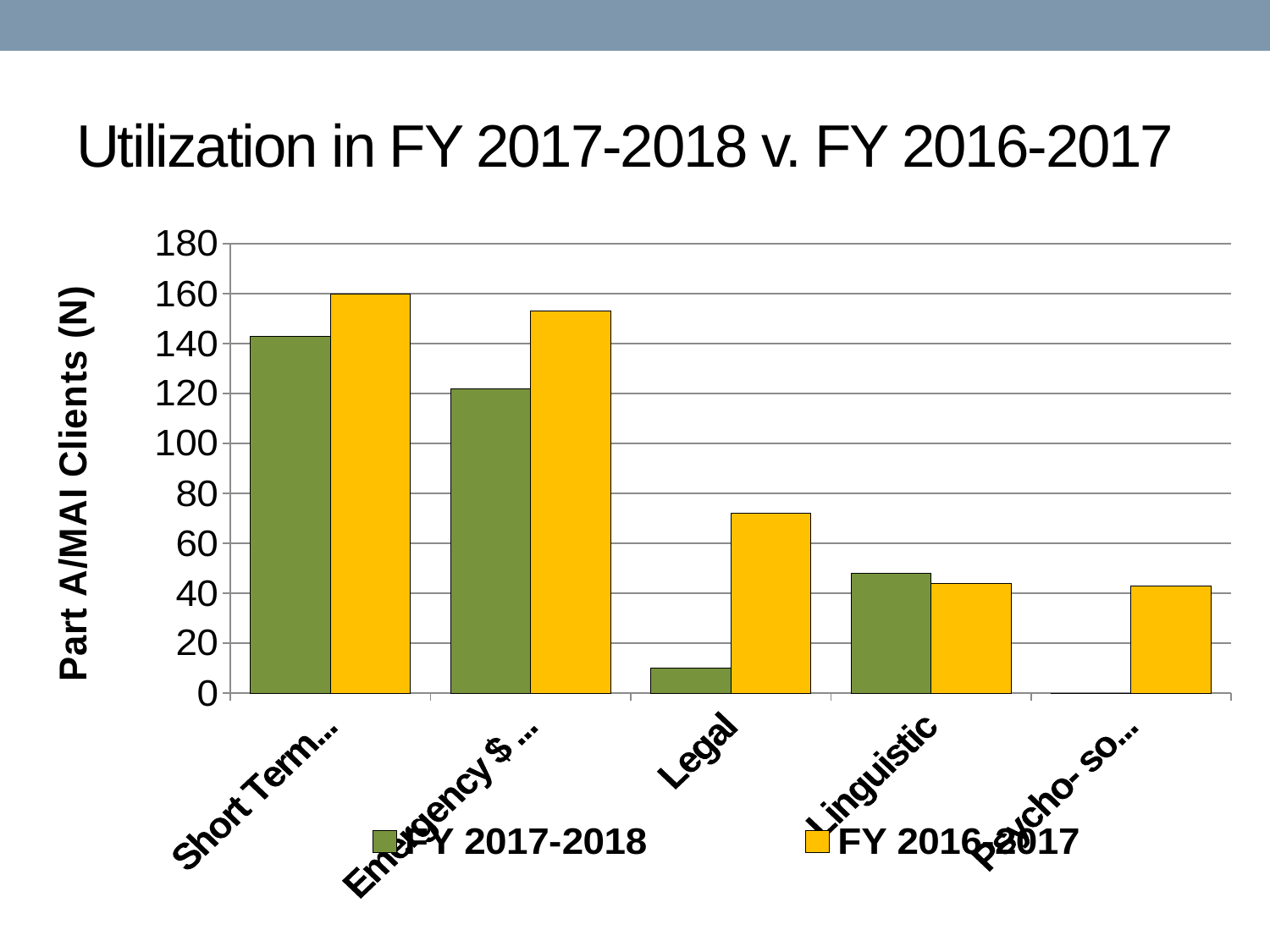
Is the FY 2017-2018 value for Legal greater or less than 20? less For Legal, which series has the larger value, FY 2017-2018 or FY 2016-2017? FY 2016-2017 What is the label of the vertical axis? Part A/MAI Clients (N) What kind of chart is shown on the slide? bar chart Is the FY 2017-2018 value for Short Term greater or less than 160? less Is the FY 2016-2017 value for Short Term greater or less than 140? greater Which category has the highest FY 2016-2017 value? Short Term How many series does the legend list? 2 How many categories are shown on the x axis? 5 What is the title of the chart? Utilization in FY 2017-2018 v. FY 2016-2017